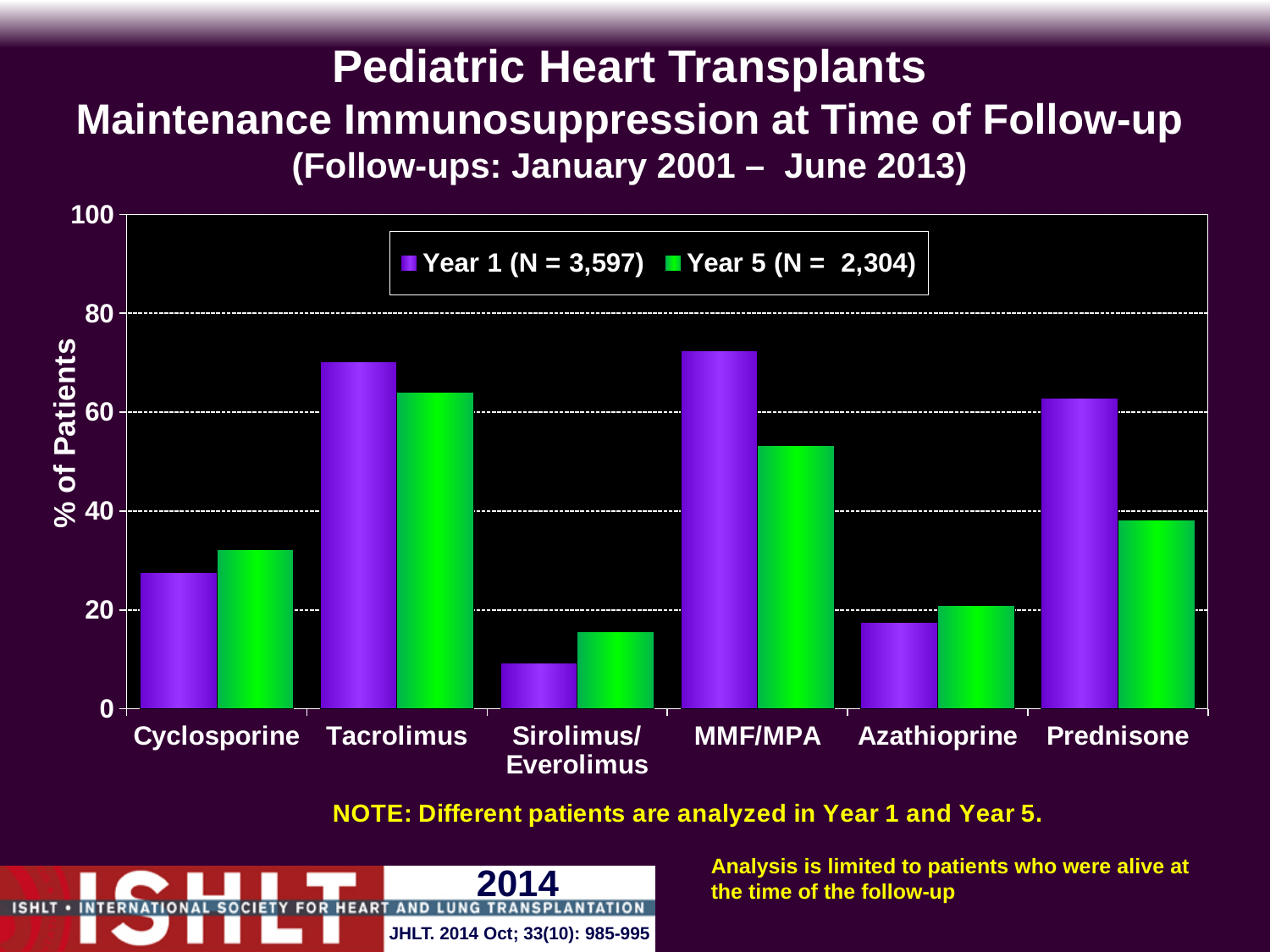
For Prednisone, which is larger: the Year 1 value or the Year 5 value? Year 1 What kind of chart is shown on the slide? bar chart Which drug has the lowest Year 1 value? Sirolimus/Everolimus What is the sample size (N) for the Year 1 series in the legend? 3,597 Is the Year 1 value for Tacrolimus greater or less than 60? greater Is the Year 5 value for MMF/MPA greater or less than 40? greater How many drug categories are shown on the x axis? 6 Is the Year 1 value for Sirolimus/Everolimus greater or less than 20? less For Cyclosporine, which is larger: the Year 1 value or the Year 5 value? Year 5 Which drug has the lowest Year 5 value? Sirolimus/Everolimus How many series does the legend list? 2 Which drug has the highest Year 5 value? Tacrolimus